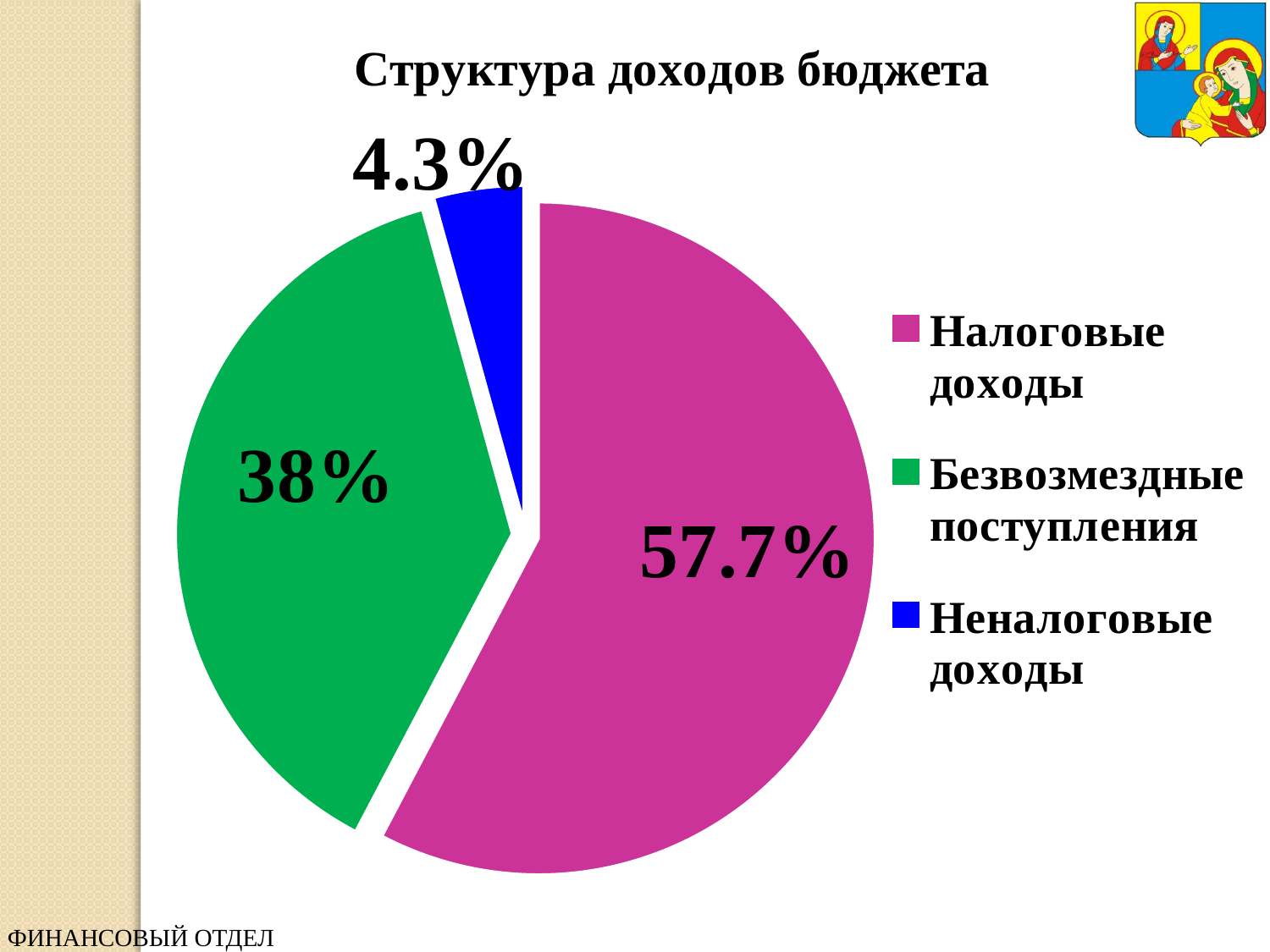
What share of the pie is Безвозмездные поступления? 38% What colour is the slice for Неналоговые доходы? Blue Which is larger: the share of Безвозмездные поступления or the share of Неналоговые доходы? Безвозмездные поступления How many categories does the pie chart have? 3 Which category has the smallest share of the pie? Неналоговые доходы What type of chart is shown on the slide? Pie chart What is the difference between the shares of Безвозмездные поступления and Неналоговые доходы? 33.7% What share of the pie is Неналоговые доходы? 4.3% What share of the pie is Налоговые доходы? 57.7% What is the difference between the shares of Налоговые доходы and Безвозмездные поступления? 19.7% Which category has the largest share of the pie? Налоговые доходы What is the title of the chart? Структура доходов бюджета